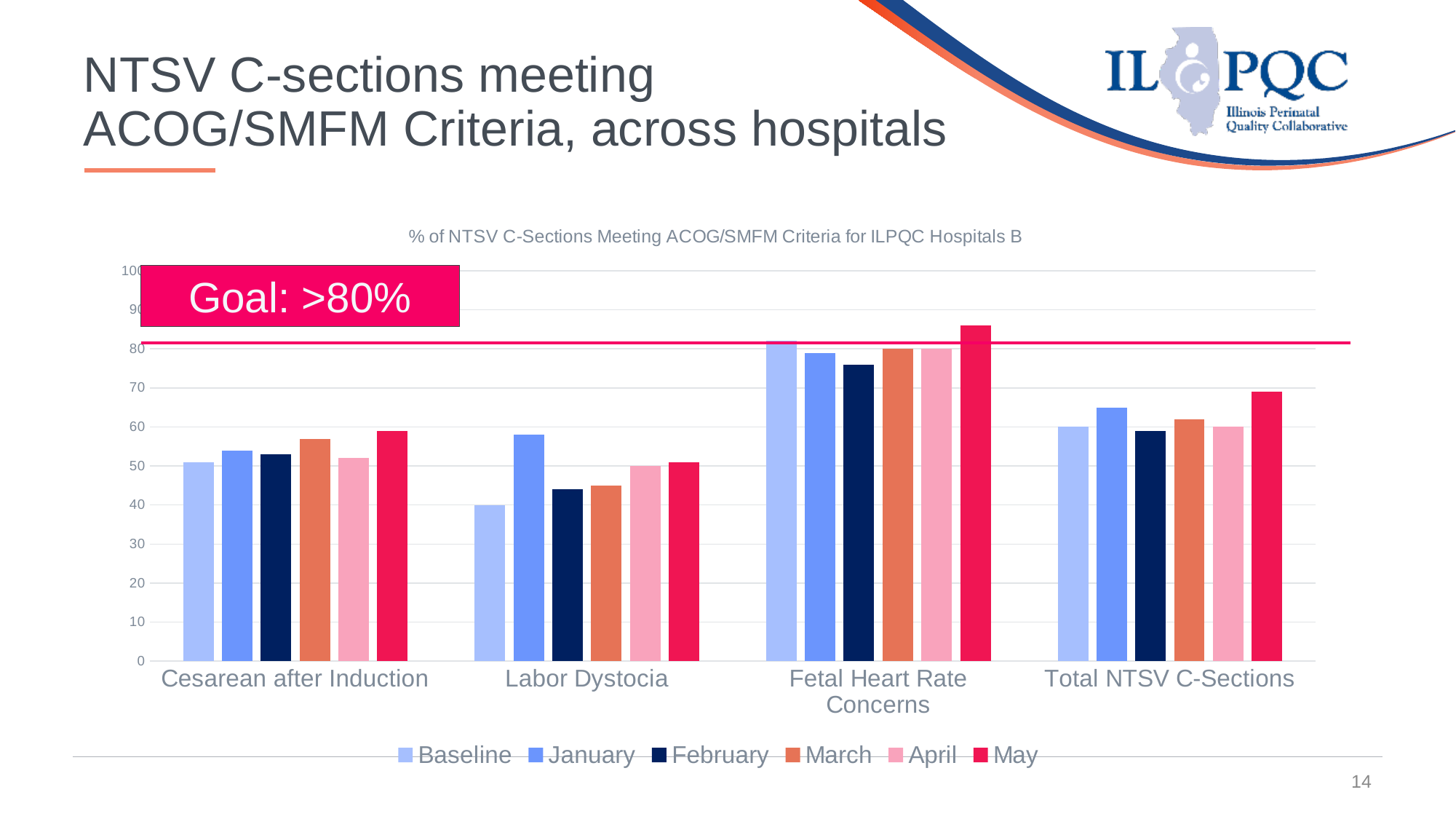
Which category has the lowest Baseline value? Labor Dystocia How many categories are shown on the x axis? 4 For Labor Dystocia, which is larger: the Baseline value or the January value? January Which category has the highest May value? Fetal Heart Rate Concerns Is the February value for Fetal Heart Rate Concerns greater or less than 80? less Is the Baseline value for Labor Dystocia greater or less than 50? less What goal is stated in the box on the chart? Goal: >80% What kind of chart is shown on the slide? bar chart How many series does the legend list? 6 For Total NTSV C-Sections, which is larger: the Baseline value or the May value? May What is the title of the chart? % of NTSV C-Sections Meeting ACOG/SMFM Criteria for ILPQC Hospitals B Is the May value for Fetal Heart Rate Concerns greater or less than 80? greater